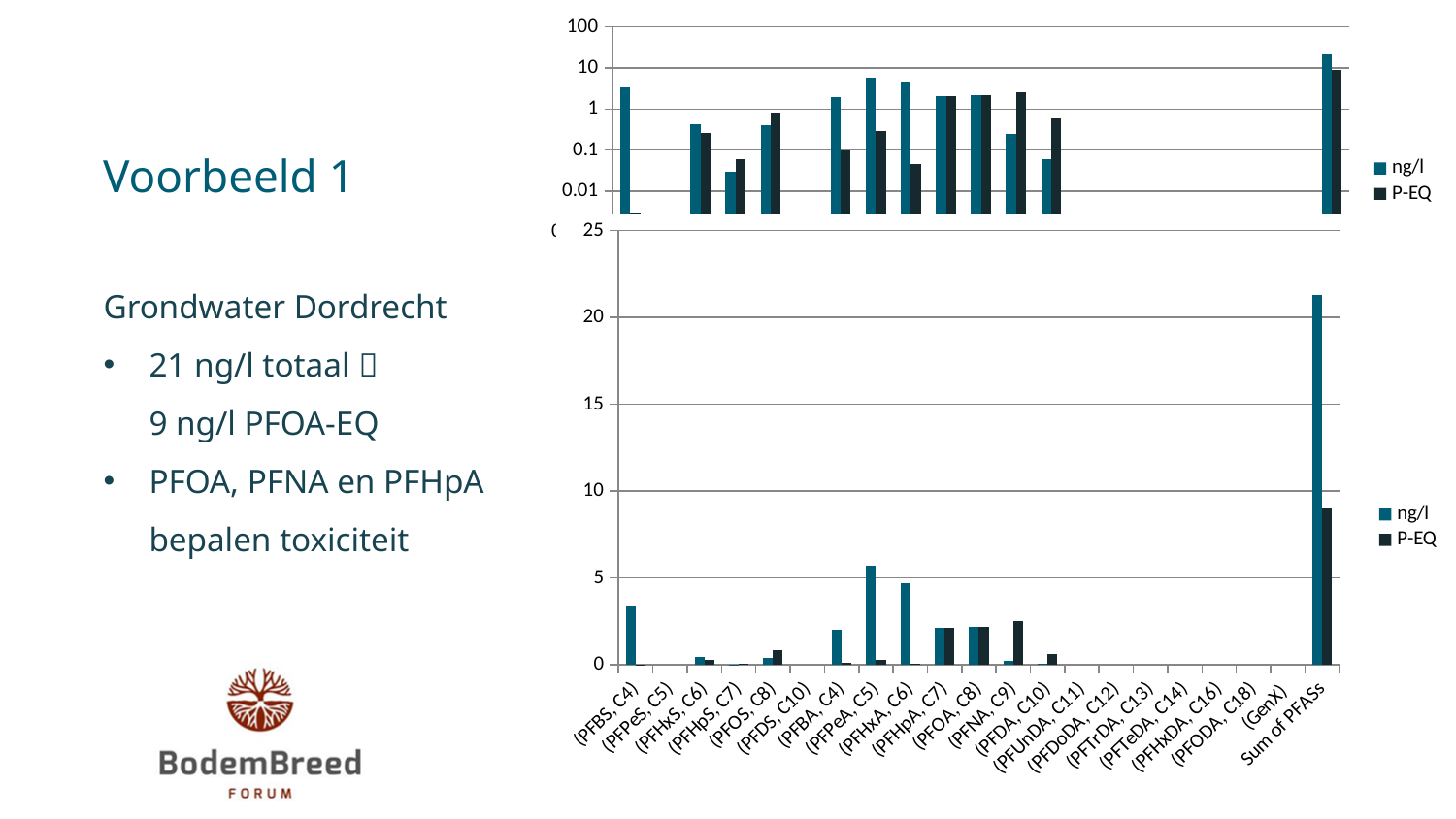
How many categories are shown on the x axis of the bottom chart? 21 In the bottom chart, which category has the highest ng/l value? Sum of PFASs What type of chart is the bottom chart on the slide? bar chart In the bottom chart, is the P-EQ value for Sum of PFASs greater or less than 10? less In the bottom chart, is the ng/l value for (PFBS, C4) greater or less than 5? less In the top chart, is the ng/l value for (PFHpS, C7) greater or less than 0.1? less In the bottom chart, which is larger: the ng/l value for (PFPeA, C5) or the ng/l value for (PFHxA, C6)? (PFPeA, C5) How many series does the legend of the bottom chart list? 2 In the bottom chart, which individual compound (excluding Sum of PFASs) has the highest ng/l value? (PFPeA, C5) What are the two series named in the legend of the bottom chart? ng/l and P-EQ